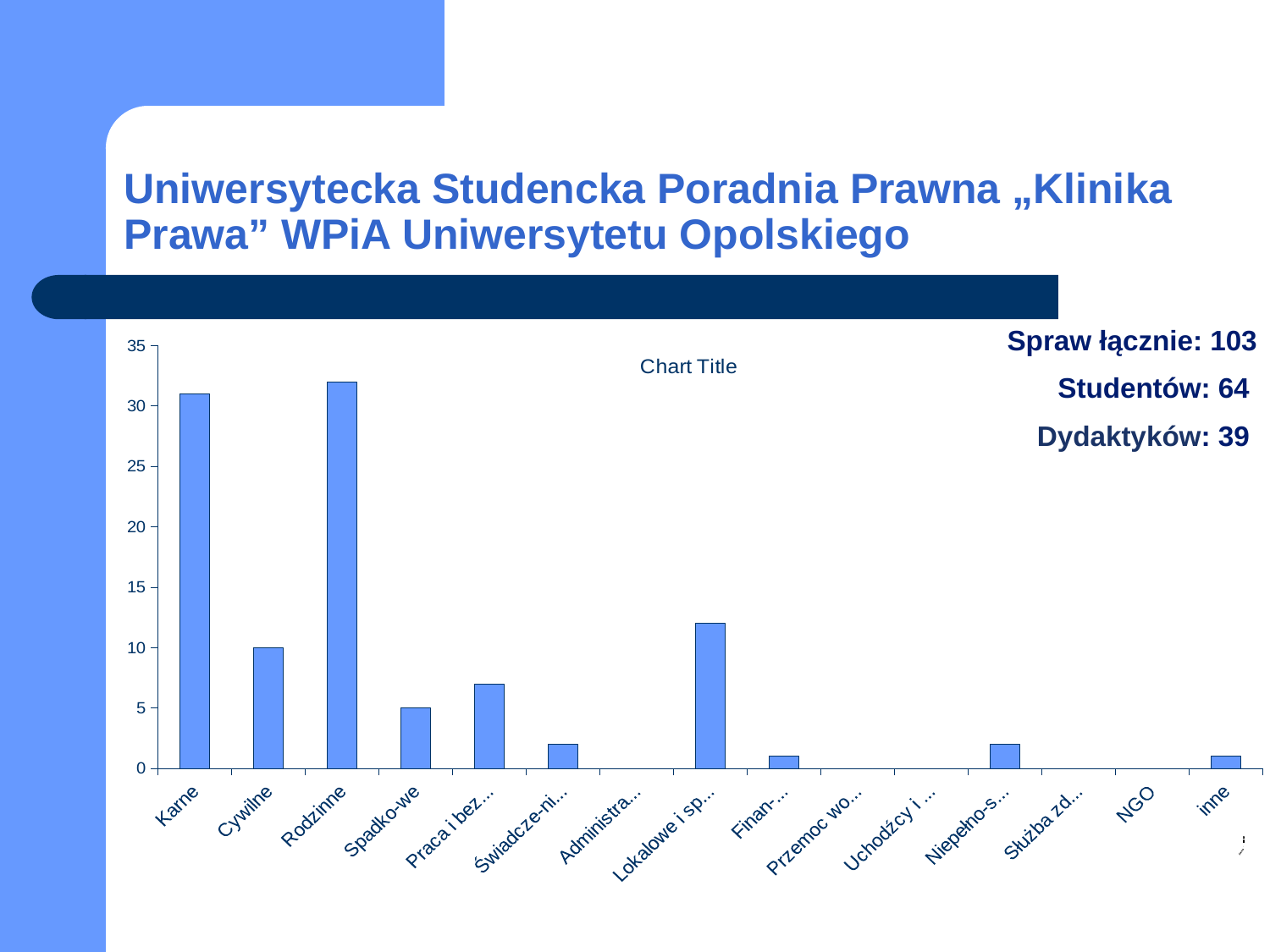
Is the value for Lokalowe i sp... greater or less than 10? greater What is the value for Spadko-we? 5 What is the value for NGO? 0 What is the difference between the values for Cywilne and Spadko-we? 5 Is the value for Praca i bez... greater or less than 10? less What is the title shown on the chart? Chart Title Which is larger, the value for Cywilne or the value for Lokalowe i sp...? Lokalowe i sp... Is the value for Świadcze-ni... greater or less than 5? less What is the value for Cywilne? 10 How many categories are shown on the x axis? 15 What kind of chart is shown on the slide? bar chart